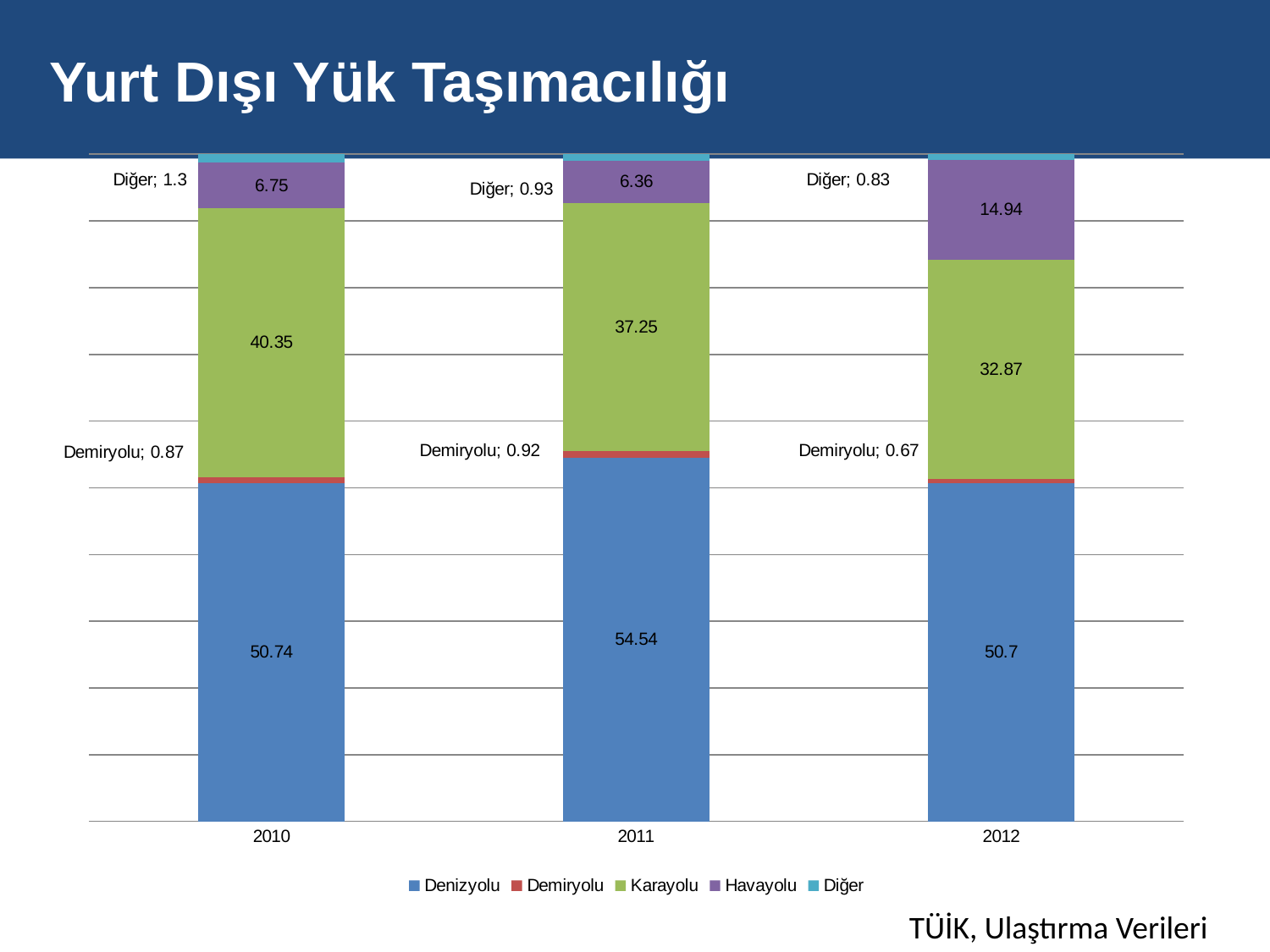
What is the value for Diğer in 2011? 0.93 What is the value for Karayolu in 2011? 37.25 Which year has the larger Havayolu value, 2010 or 2012? 2012 How many series does the legend list? 5 Does the Karayolu value rise or fall from 2010 to 2012? Fall In which year is the Karayolu value lowest? 2012 What is the difference between the Karayolu value in 2010 and in 2012? 7.48 What kind of chart is shown on the slide? Stacked bar chart What is the value for Havayolu in 2012? 14.94 What is the value for Demiryolu in 2010? 0.87 In which year is the Denizyolu value highest? 2011 How many years are shown on the x axis? 3